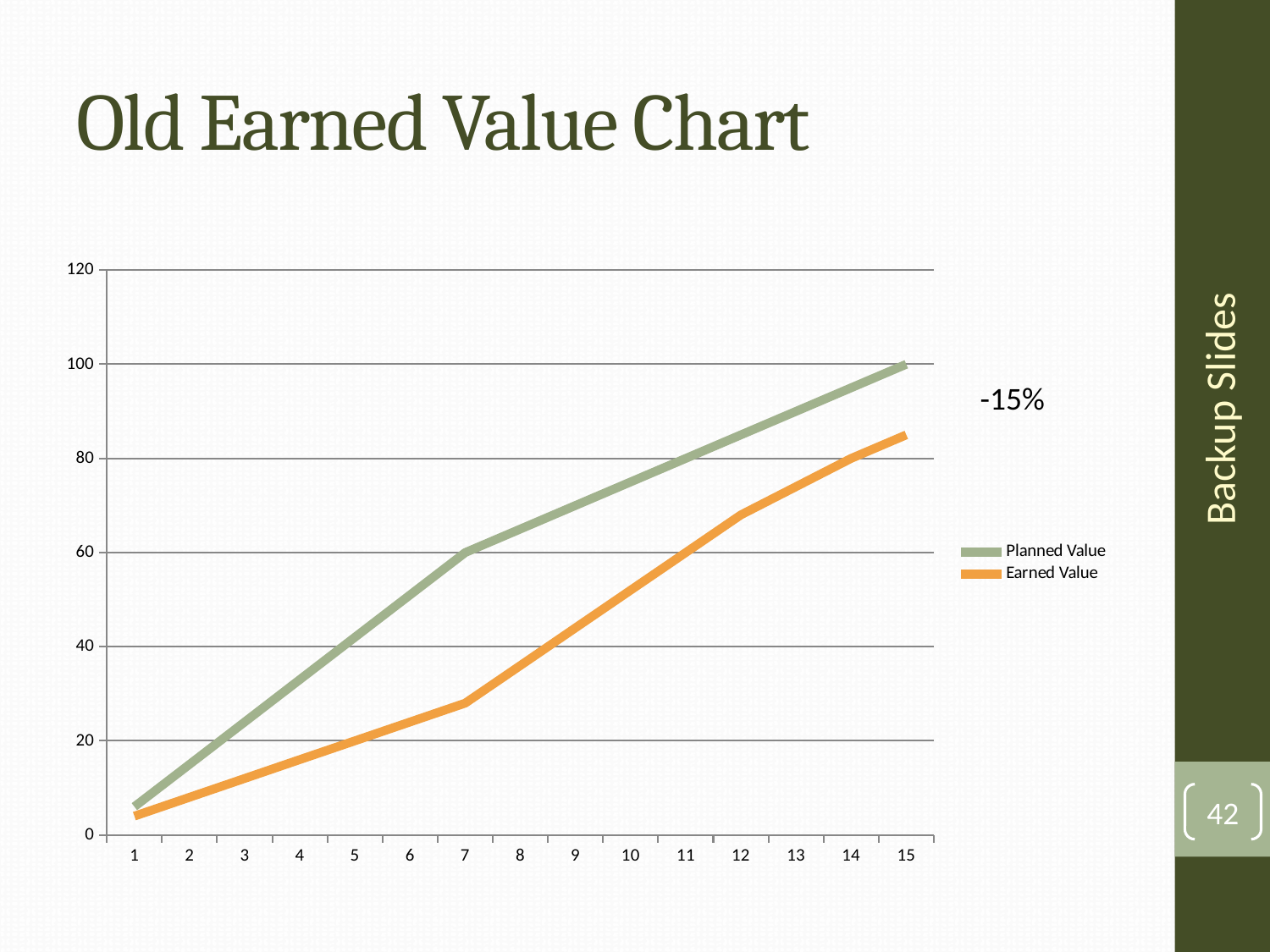
What are the two series named in the legend? Planned Value and Earned Value Is the Earned Value at point 15 greater or less than 80? greater What percentage annotation is shown to the right of the lines? -15% What is the Planned Value at point 15? 100 Is the Planned Value at point 10 greater or less than 60? greater How many series does the legend list? 2 How many points are marked along the x axis? 15 What kind of chart is shown on the slide? line chart At point 12, which series has the larger value, Planned Value or Earned Value? Planned Value Is the Earned Value at point 7 greater or less than 40? less Do the Earned Value figures rise or fall from point 1 to point 15? rise